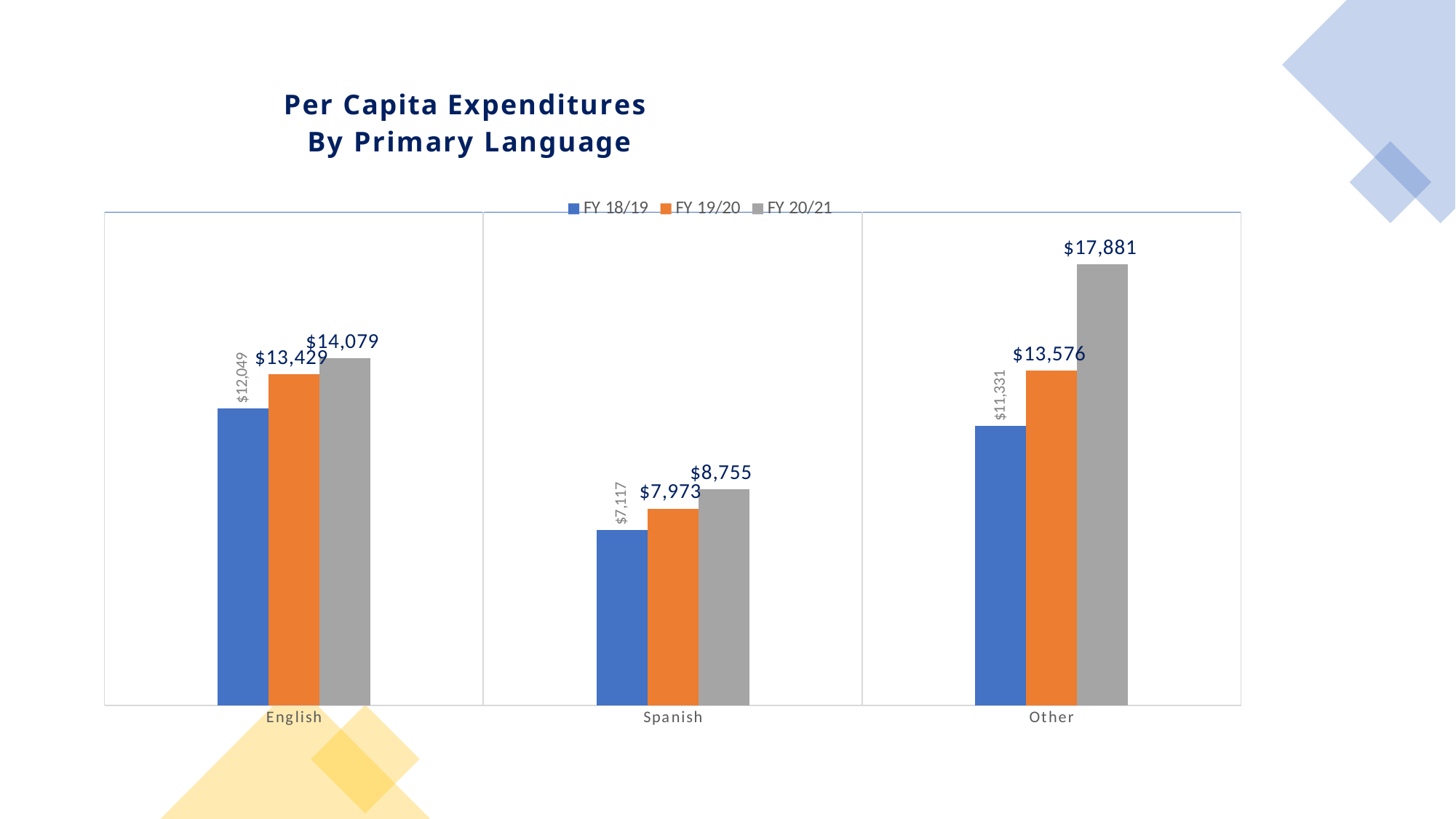
Which primary language has the highest per capita expenditure in FY 20/21? Other Which is larger: the FY 19/20 value for English or the FY 19/20 value for Other? Other What is the per capita expenditure for Spanish in FY 18/19? $7,117 What is the per capita expenditure for English in FY 20/21? $14,079 How many primary language categories are shown on the chart? 3 Which primary language has the lowest per capita expenditure in FY 18/19? Spanish How many series does the legend list? 3 What is the difference between the FY 20/21 and FY 18/19 per capita expenditures for Other? $6,550 What is the per capita expenditure for Other in FY 19/20? $13,576 Do the per capita expenditures for Spanish rise or fall from FY 18/19 to FY 20/21? Rise What kind of chart is shown on the slide? Bar chart What is the difference between the FY 19/20 per capita expenditures for English and Spanish? $5,456